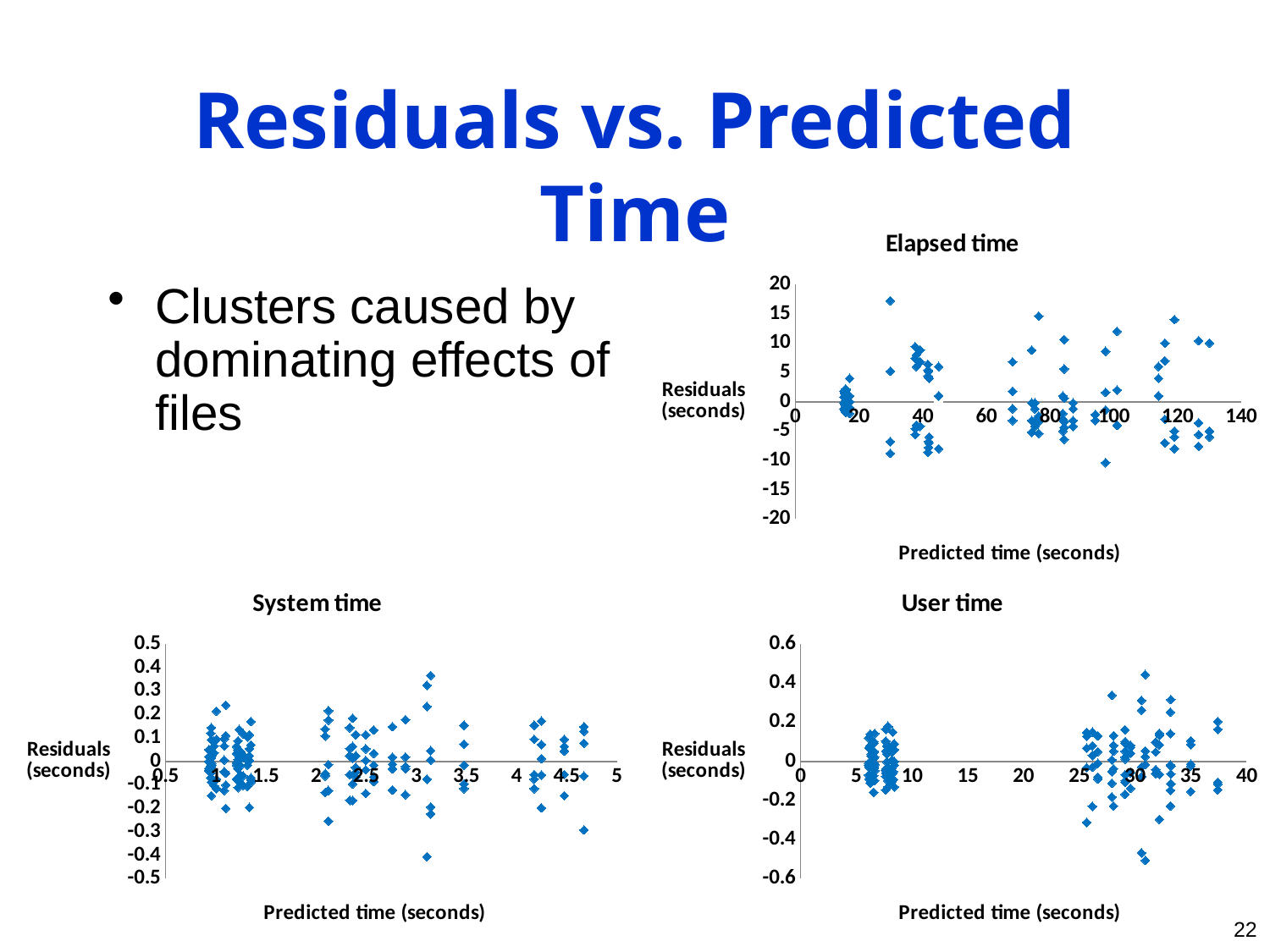
What kind of chart is the "System time" chart at the bottom left? Scatter chart In the "Elapsed time" chart, is the highest residual value greater or less than 15? greater In the "Elapsed time" chart, is the lowest residual value greater or less than -5? less In the "Elapsed time" chart, is the residual of the point near a predicted time of 30 seconds at the top of the chart greater or less than 10? greater What is the x-axis label of the "User time" chart? Predicted time (seconds) What is the title of the chart in the top right of the slide? Elapsed time What kind of chart is the "Elapsed time" chart? Scatter chart